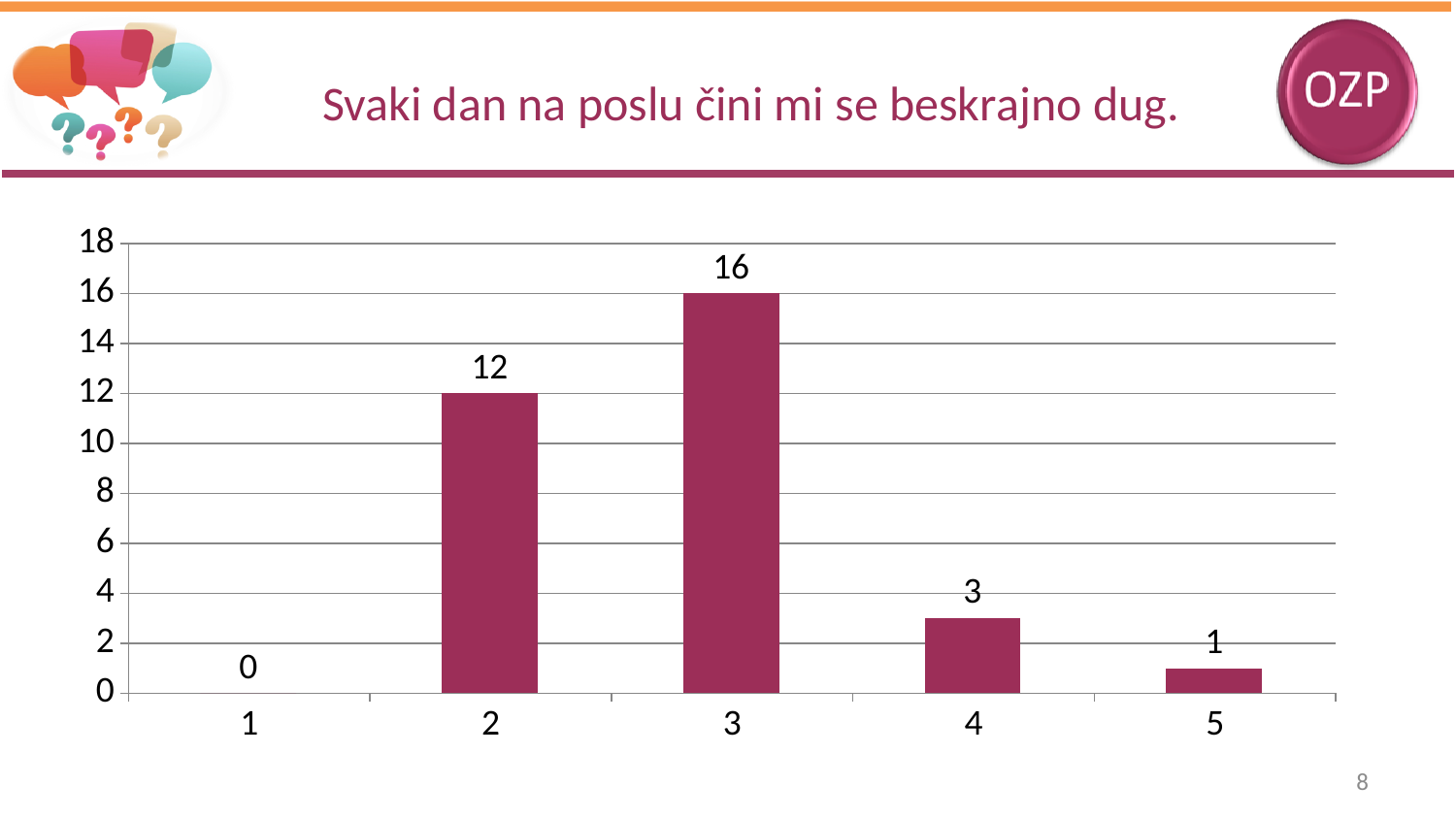
What is the difference between the values for categories 3 and 2? 4 What is the value for category 1? 0 What kind of chart is shown on the slide? bar chart What is the title of the slide above the chart? Svaki dan na poslu čini mi se beskrajno dug. What is the value for category 2? 12 What is the value for category 5? 1 How many categories are shown on the x axis? 5 What is the difference between the values for categories 4 and 5? 2 Which is larger, the value for category 2 or the value for category 4? 2 Which category has the lowest value? 1 Which category has the highest value? 3 What is the value for category 3? 16